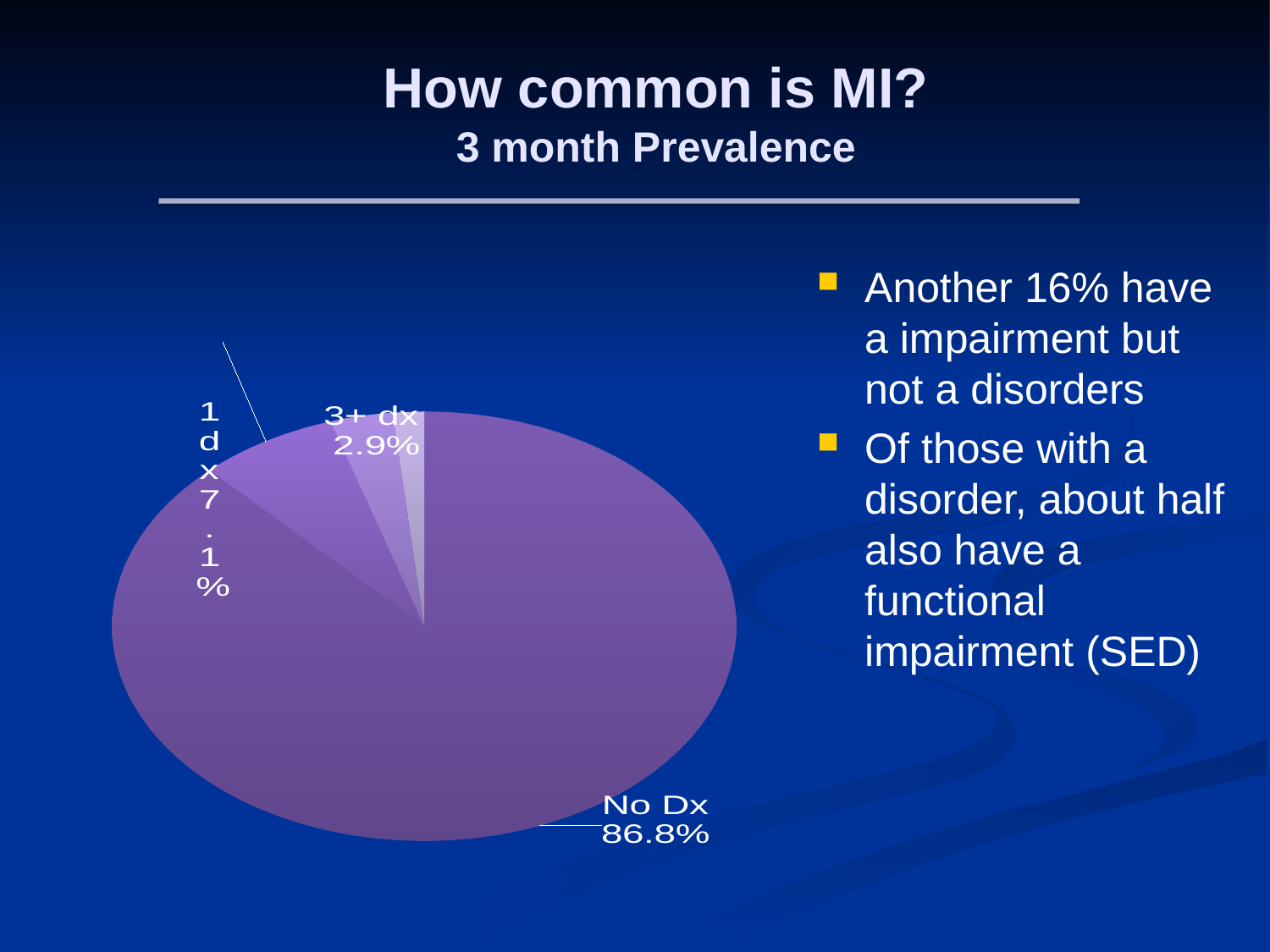
What percentage does the "3+ dx" slice represent? 2.9% What is the difference in percentage points between the "1 dx" slice and the "3+ dx" slice? 4.2 What share of the pie does "No Dx" account for? 86.8% Which is larger, the "No Dx" slice or the "1 dx" slice? No Dx What percentage of the pie chart is labelled "No Dx"? 86.8% What is the title of the slide containing the chart? How common is MI? 3 month Prevalence What type of chart is shown on the slide? Pie chart What percentage does the "1 dx" slice represent? 7.1% What is the difference in percentage points between the "No Dx" slice and the "1 dx" slice? 79.7 Which is larger, the "1 dx" slice or the "3+ dx" slice? 1 dx Which category has the largest slice of the pie chart? No Dx